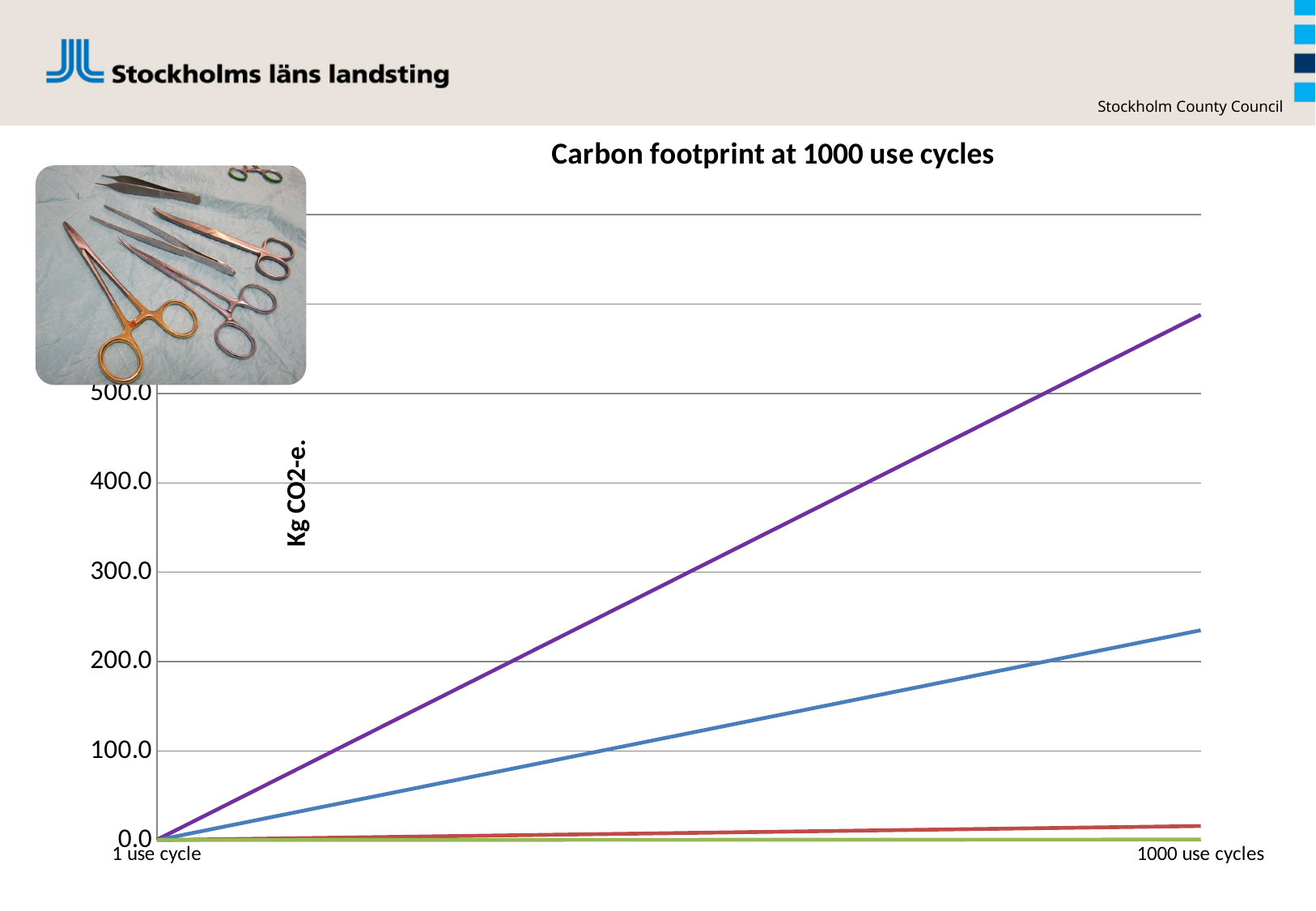
Is the value of the red line at 1000 use cycles greater or less than 100.0? less Is the value of the blue line at 1000 use cycles greater or less than 200.0? greater How many lines are plotted on the chart? 4 Which line reaches the highest value at 1000 use cycles? the purple line How many points are labelled along the x axis of the chart? 2 Is the value of the purple line at 1000 use cycles greater or less than 500.0? greater At 1000 use cycles, which is larger: the value of the purple line or the value of the blue line? the purple line What is the label on the vertical axis of the chart? Kg CO2-e. Do the lines on the chart rise or fall from 1 use cycle to 1000 use cycles? rise What is the title of the chart? Carbon footprint at 1000 use cycles What kind of chart is shown on the slide? line chart